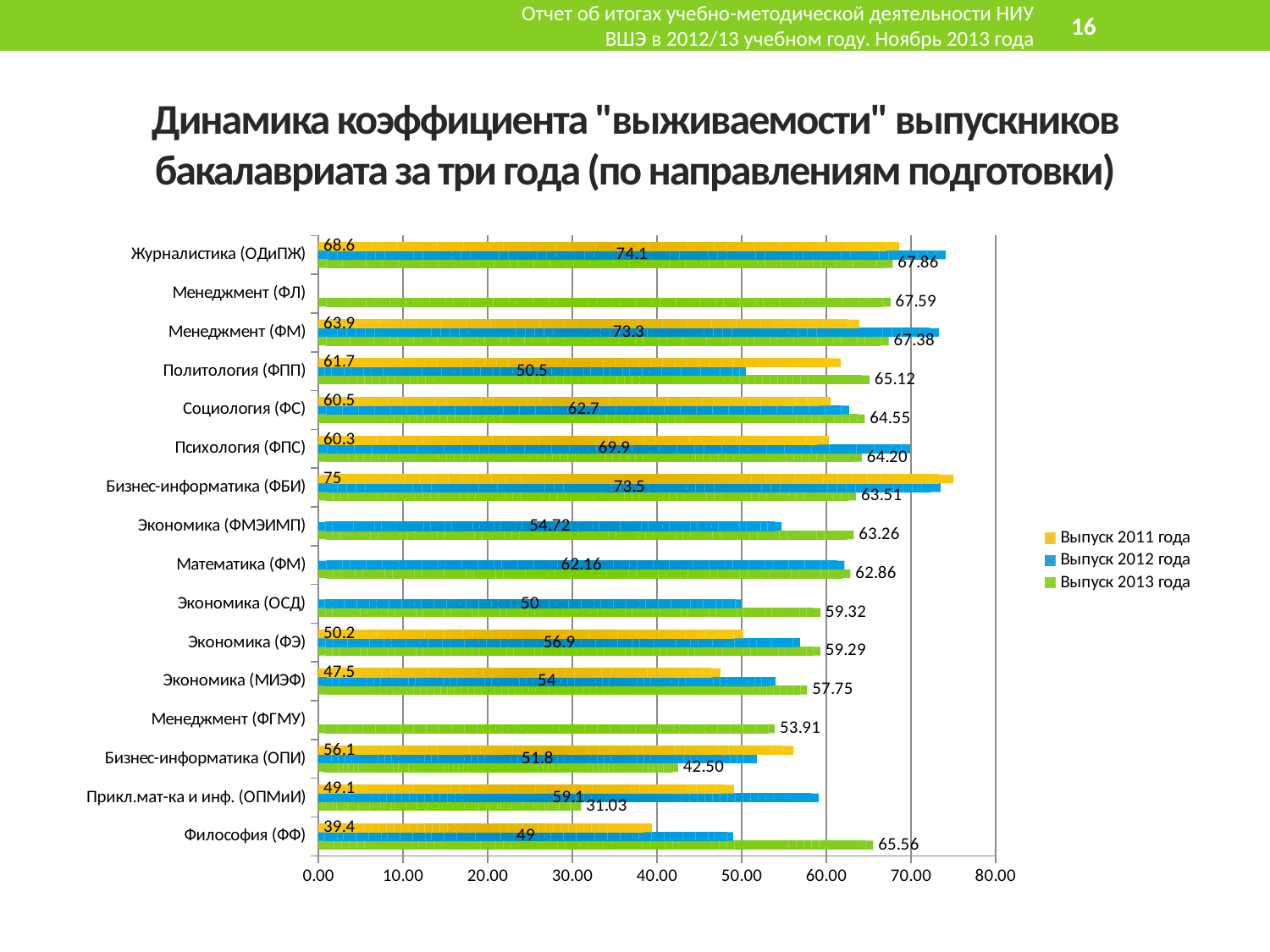
What is the value for Экономика (ОСД) in the Выпуск 2012 года series? 50 What kind of chart is shown on the slide? Bar chart How many categories are shown on the chart? 16 For Политология (ФПП), which is larger: the Выпуск 2011 года value or the Выпуск 2012 года value? Выпуск 2011 года Which category has the lowest value in the Выпуск 2011 года series? Философия (ФФ) Which category has the lowest value in the Выпуск 2013 года series? Прикл.мат-ка и инф. (ОПМиИ) What is the difference between the Выпуск 2011 года and Выпуск 2013 года values for Бизнес-информатика (ОПИ)? 13.6 What is the value for Философия (ФФ) in the Выпуск 2013 года series? 65.56 What is the difference between the Выпуск 2013 года and Выпуск 2011 года values for Философия (ФФ)? 26.16 Which category has the highest value in the Выпуск 2011 года series? Бизнес-информатика (ФБИ) How many series does the legend list? 3 What is the value for Журналистика (ОДиПЖ) in the Выпуск 2012 года series? 74.1